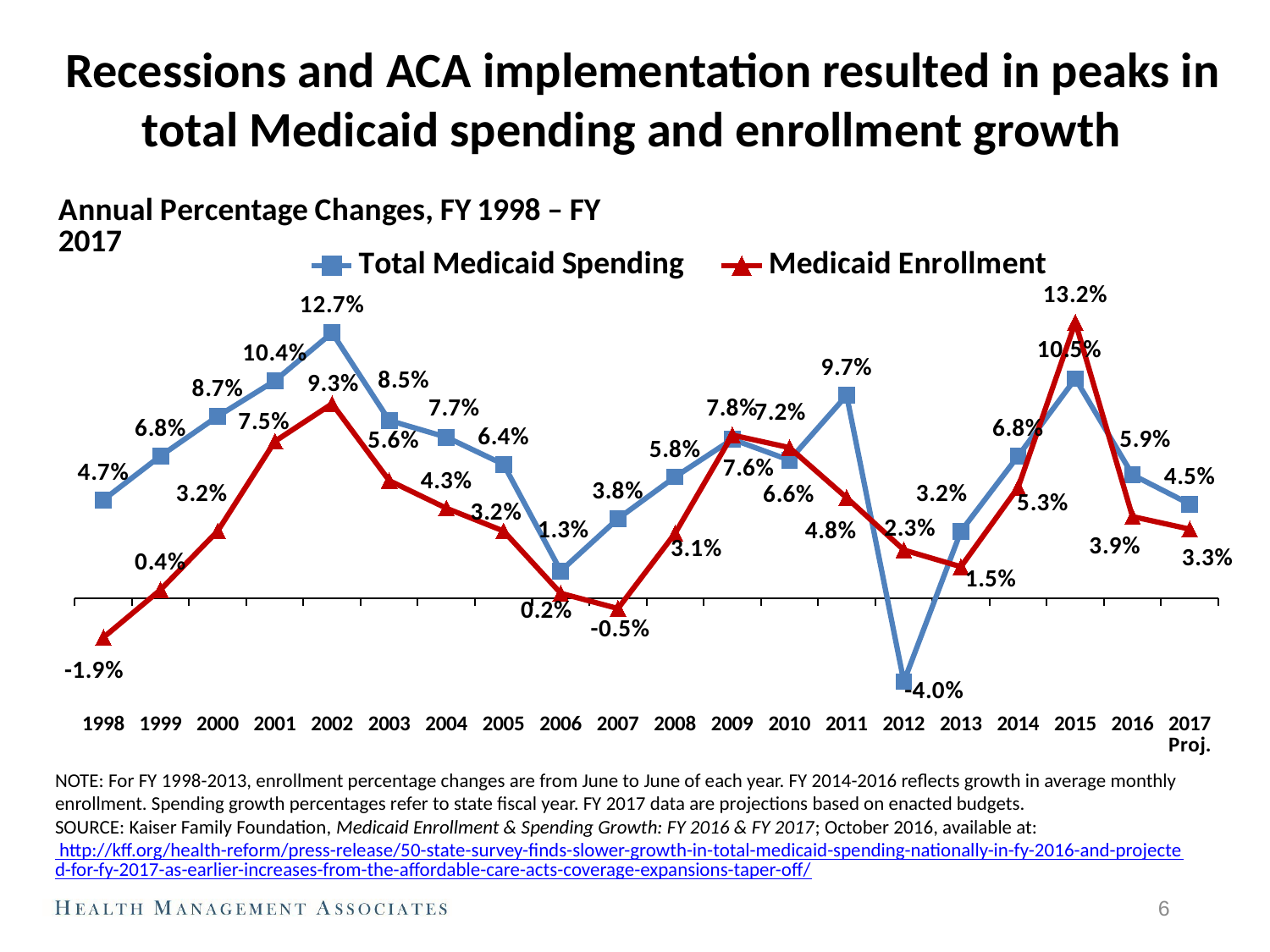
What type of chart is shown on the slide? Line chart Did Total Medicaid Spending growth rise or fall from 2015 to 2017 Proj.? Fall What was the annual percentage change in Medicaid Enrollment in FY 2015? 13.2% Which was larger in FY 2015: the Total Medicaid Spending change or the Medicaid Enrollment change? Medicaid Enrollment What is the difference between the Total Medicaid Spending change in 2011 (9.7%) and the Medicaid Enrollment change in 2011 (4.8%)? 4.9% What was the annual percentage change in Total Medicaid Spending in FY 2002? 12.7% In which year did Medicaid Enrollment have its highest annual percentage change? 2015 How many series does the legend list? 2 In which year did Total Medicaid Spending have its lowest annual percentage change? 2012 What is the projected annual percentage change in Total Medicaid Spending for FY 2017? 4.5% What was the annual percentage change in Medicaid Enrollment in FY 1998? -1.9% How many years are plotted on the x axis? 20